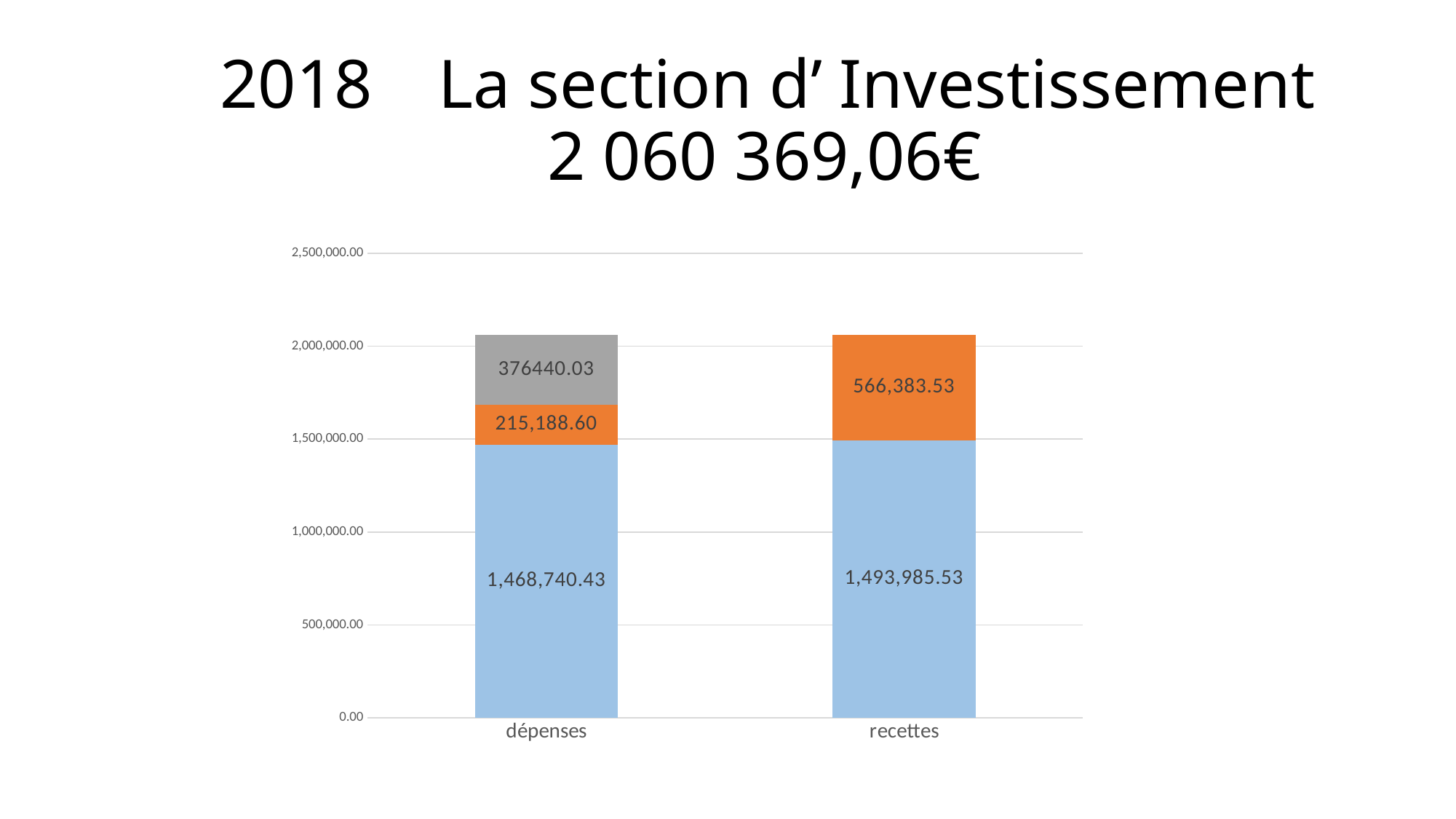
What is the total of the dépenses bar? 2,060,369.06 Is the total height of the dépenses bar greater or less than 2,000,000.00? greater What is the value of the orange segment of the dépenses bar? 215,188.60 What kind of chart is shown on the slide? Stacked bar chart How many categories are shown on the x axis? 2 What is the value of the grey (top) segment of the dépenses bar? 376440.03 What is the total of the recettes bar? 2,060,369.06 What is the difference between the orange segment of recettes and the orange segment of dépenses? 351,194.93 Which bar has the larger orange segment, dépenses or recettes? recettes What is the value of the bottom (blue) segment of the dépenses bar? 1,468,740.43 What is the value of the bottom (blue) segment of the recettes bar? 1,493,985.53 What is the value of the orange segment of the recettes bar? 566,383.53